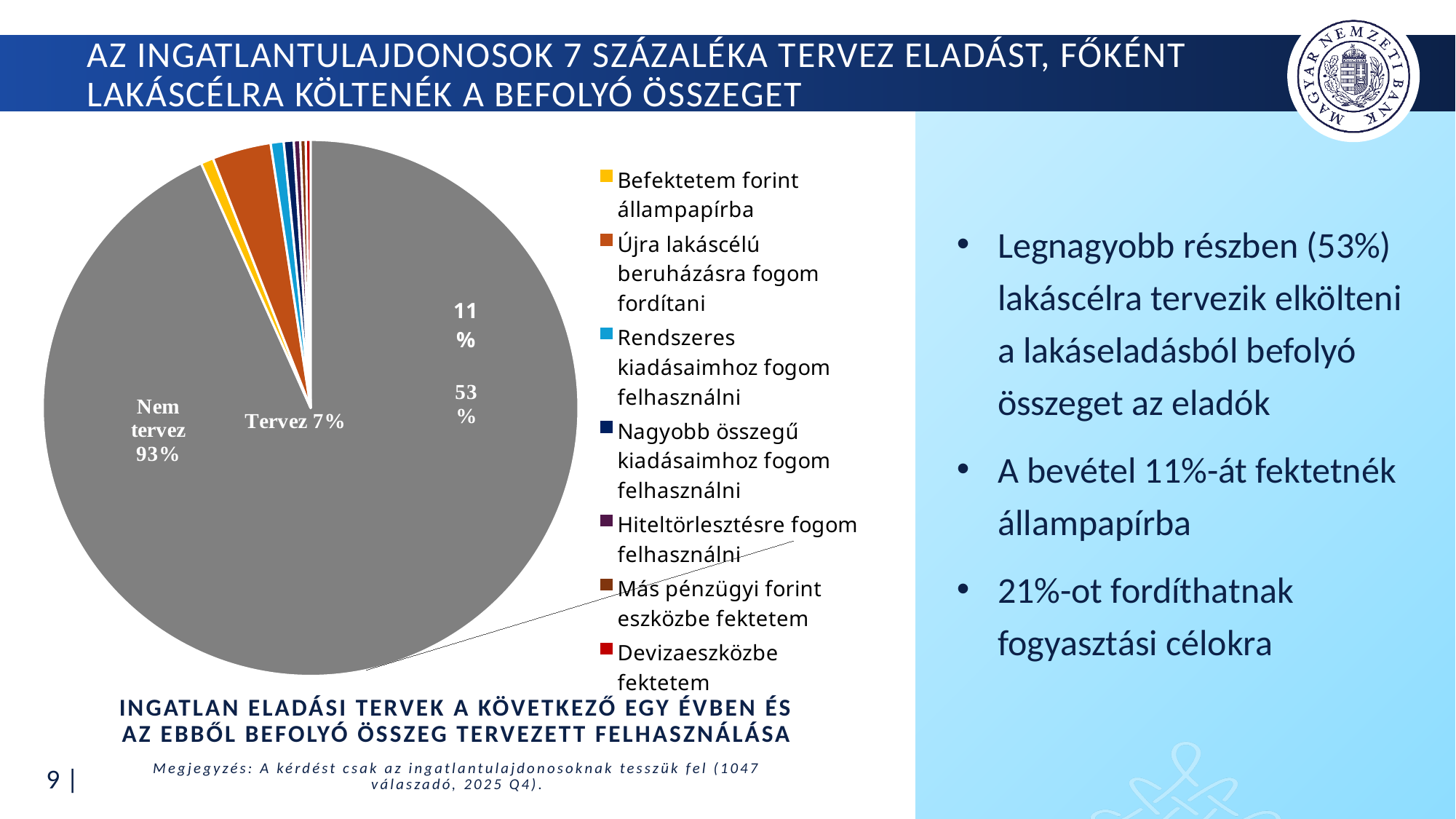
What colour is the legend marker for "Devizaeszközbe fektetem"? Red What is the difference in percentage points between the "Nem tervez" and "Tervez" slices? 86 percentage points What colour is the "Nem tervez" slice in the pie chart? Grey What share of property owners is labelled "Nem tervez" in the pie chart? 93% Which of the two main slices, "Nem tervez" or "Tervez", is larger? Nem tervez How many entries does the legend of the pie chart list? 7 What percentage is shown for the slice "Újra lakáscélú beruházásra fogom fordítani"? 53% What kind of chart is shown on the slide? Pie chart What share of property owners is labelled "Tervez" in the pie chart? 7% What percentage is shown for the slice "Befektetem forint állampapírba"? 11% Is the value for "Nem tervez" greater or less than 50%? greater Which labelled slice of the pie chart is the largest? Nem tervez (93%)